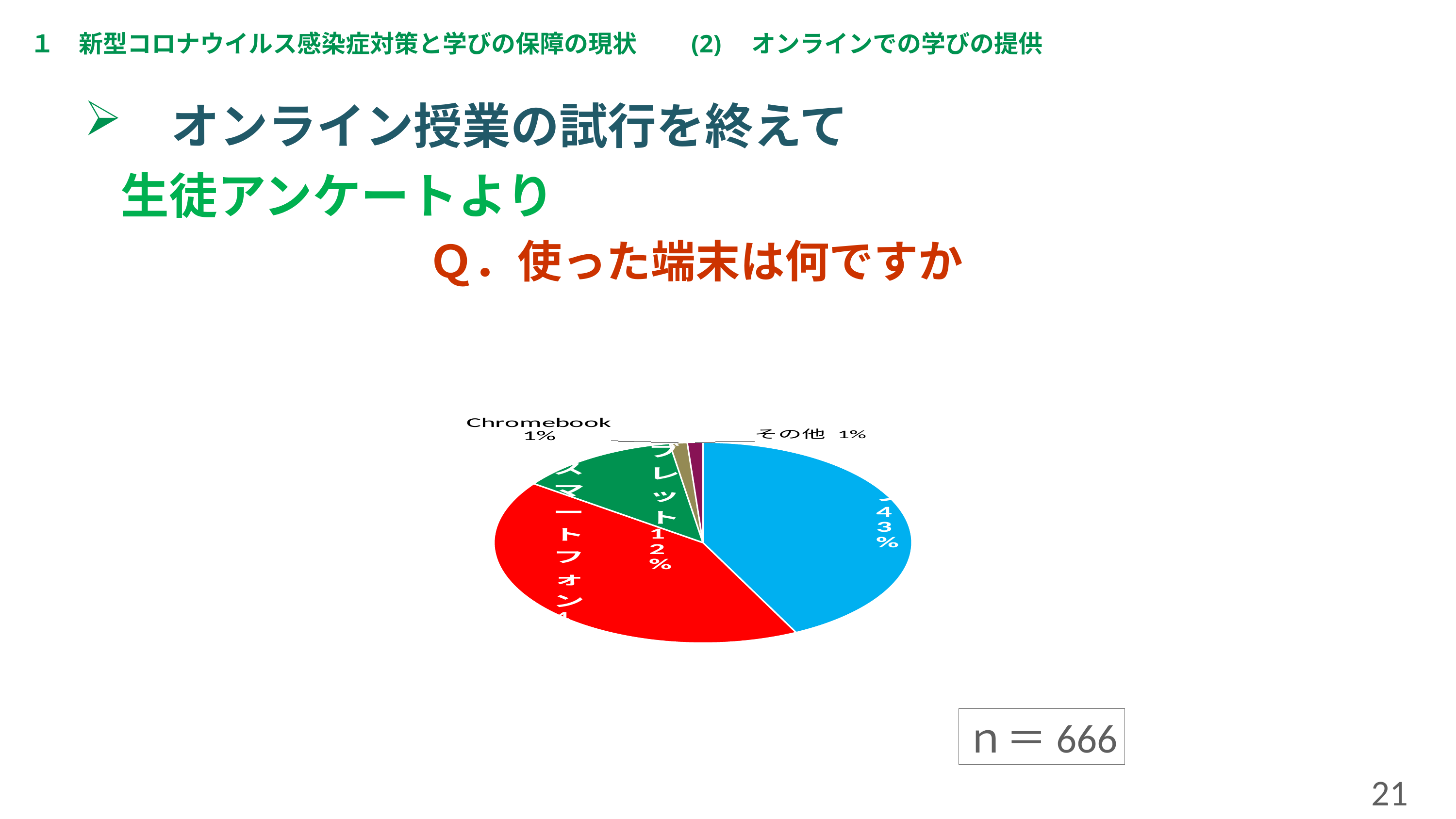
Which slice is larger, スマートフォン or タブレット? スマートフォン Which slice is larger, タブレット or Chromebook? タブレット What kind of chart is shown on the slide? pie chart What percentage of the pie is labelled Chromebook? 1% How many slices does the pie chart have? 5 By how many percentage points does the タブレット slice exceed the その他 slice? 11 What survey question does the pie chart answer, as written in orange on the slide? Q．使った端末は何ですか What percentage of the pie is labelled タブレット? 12% Which slice is larger, タブレット or その他? タブレット By how many percentage points does the タブレット slice exceed the Chromebook slice? 11 What percentage of the pie is labelled その他? 1% What is the sample size (n) shown next to the pie chart? n = 666